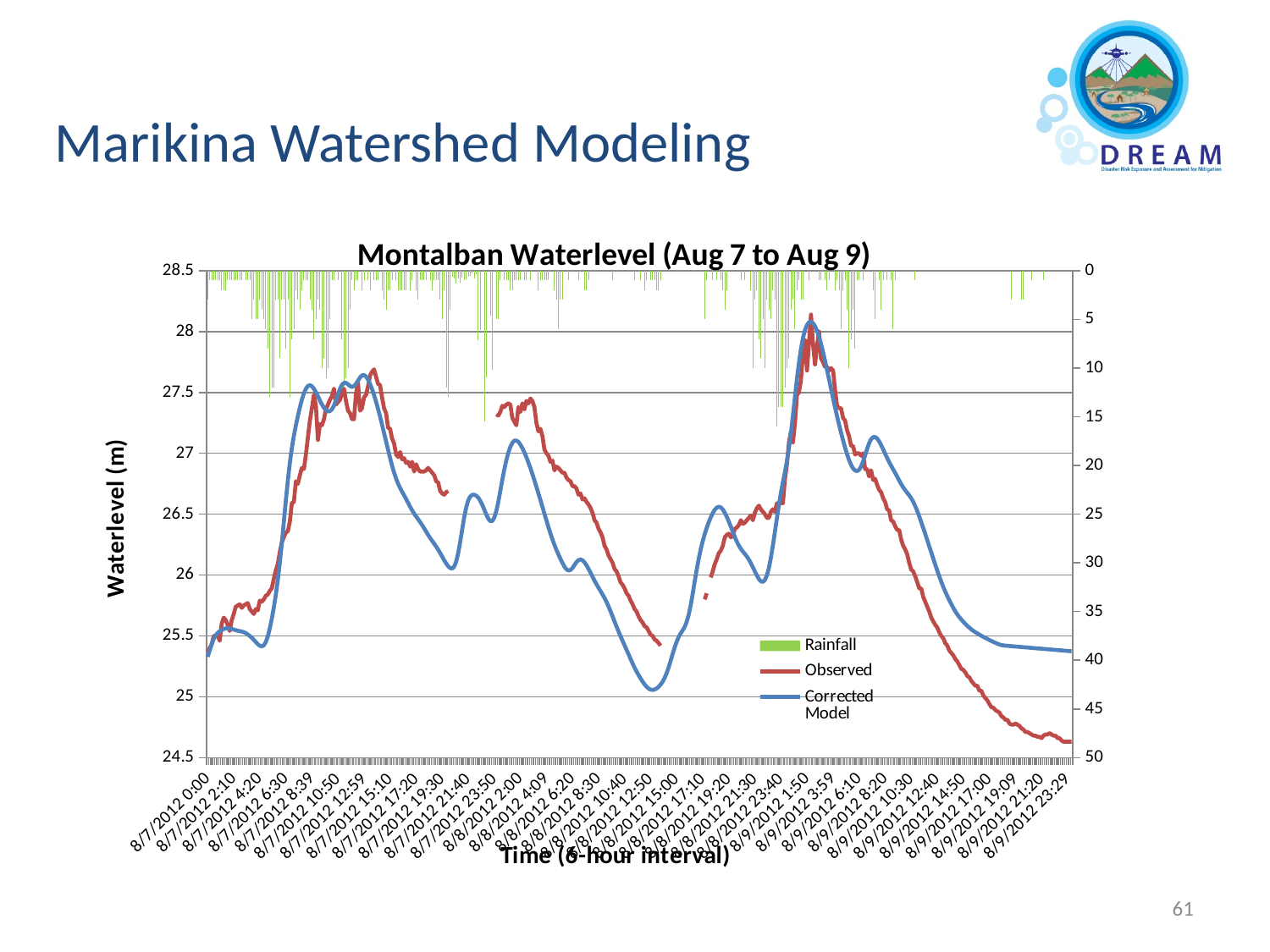
Does the Corrected Model water level rise or fall from 8/7/2012 4:20 to 8/7/2012 8:39? rise Is the Corrected Model water level at the last time point (8/9/2012 23:29) greater or less than 25? greater What is the title of the chart? Montalban Waterlevel (Aug 7 to Aug 9) How many series does the chart legend list? 3 Is the Observed water level at the last time point (8/9/2012 23:29) greater or less than 25? less Around 8/8/2012 10:40, which series shows the higher water level, Observed or Corrected Model? Observed At the last time point (8/9/2012 23:29), which series shows the higher water level, Observed or Corrected Model? Corrected Model Does the Observed water level rise or fall from 8/9/2012 8:20 to the end of the chart? fall Is the Corrected Model water level at the first time point (8/7/2012 0:00) greater or less than 25.5? less What is the label of the left vertical axis? Waterlevel (m) What kind of chart is used to show the Observed and Corrected Model series? line chart